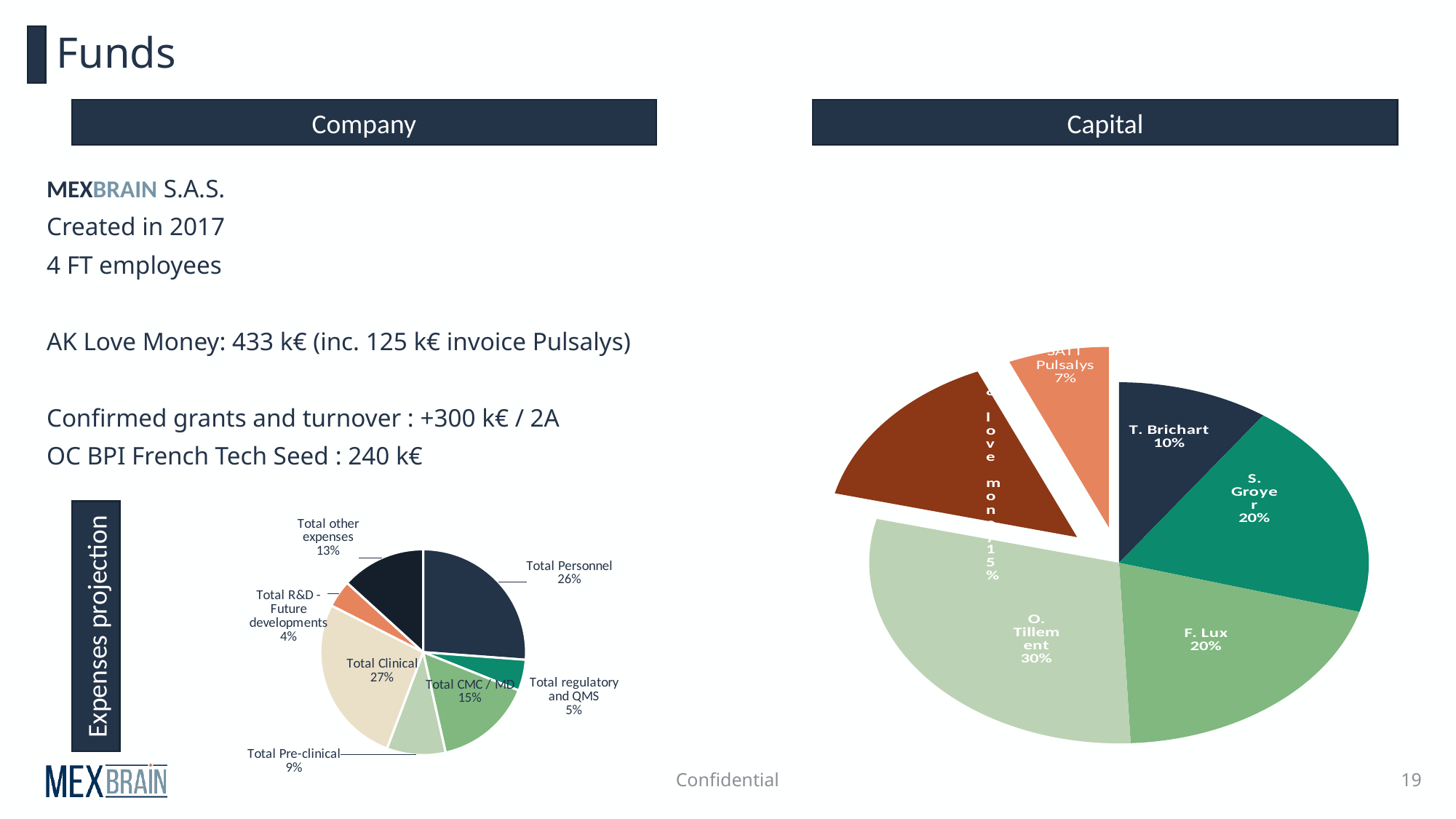
In the Capital pie chart, who holds a larger share, T. Brichart or S. Groyer? S. Groyer How many slices does the Expenses projection pie chart have? 7 How many slices does the Capital pie chart have? 6 In the Expenses projection pie chart, which category has the largest share? Total Clinical In the Capital pie chart, which shareholder has the largest share? O. Tillement What type of chart is the Capital chart? Pie chart In the Expenses projection pie chart, what share is Total Pre-clinical? 9% In the Expenses projection pie chart, what is the difference in percentage points between Total Clinical and Total CMC / MD? 12 percentage points In the Expenses projection pie chart, which category has the smallest share? Total R&D - Future developments In the Capital pie chart, what share does O. Tillement hold? 30% In the Expenses projection pie chart, what share is Total Personnel? 26% In the Capital pie chart, which shareholder has the smallest share? SATT Pulsalys